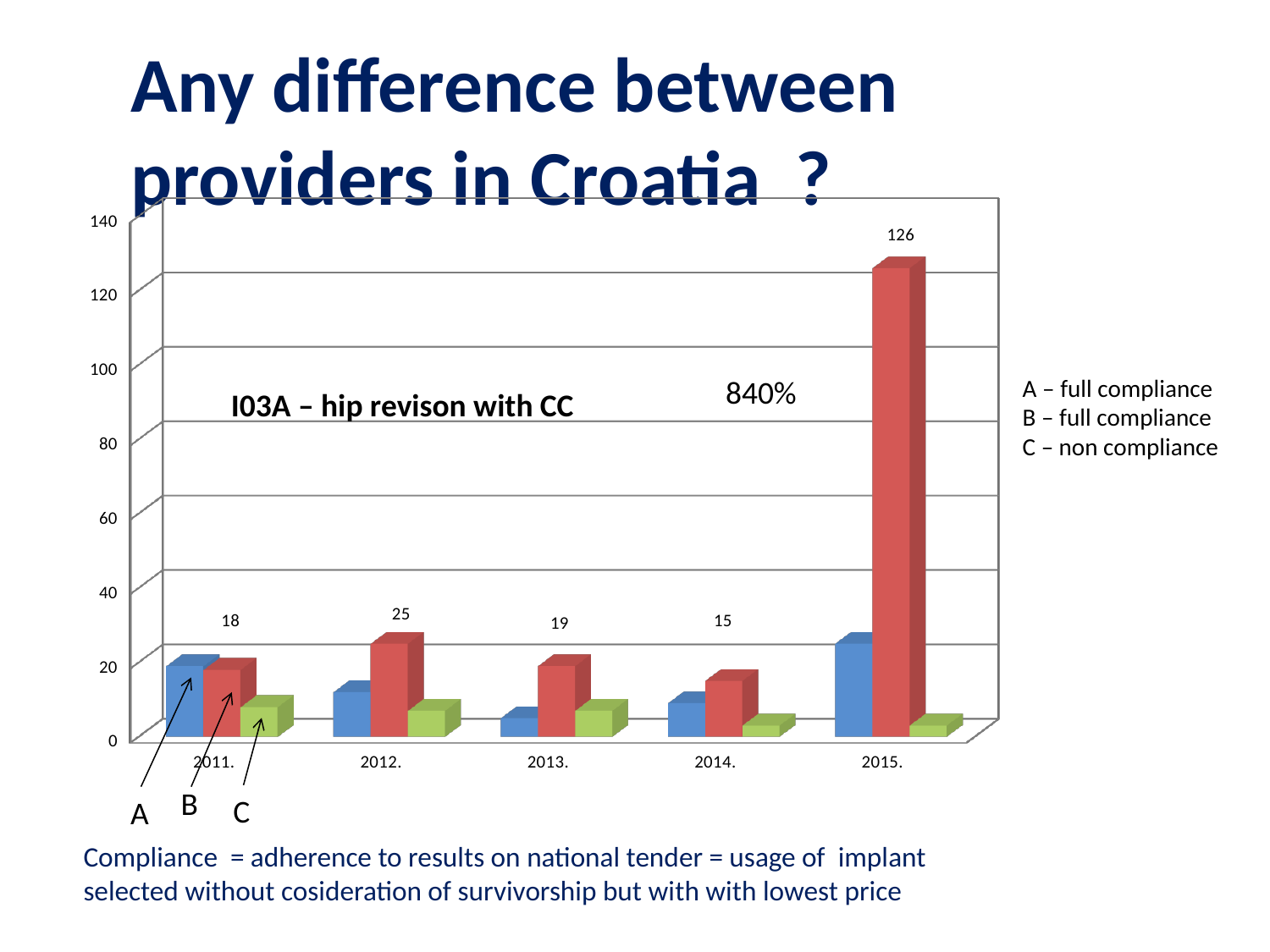
In which year is the labelled value for series B highest? 2015. What is the title printed inside the chart area? I03A – hip revison with CC What is the value labelled for series B in 2015? 126 How many years are shown on the x axis? 5 What is the value labelled for series B in 2014? 15 Which year has the larger series B value, 2012 or 2013? 2012. What is the difference between the series B values for 2015 and 2014? 111 What is the value labelled for series B in 2011? 18 In which year is the labelled value for series B lowest? 2014. What kind of chart is shown on the slide? bar chart Is the value for series A in 2015 greater or less than 40? less What is the value labelled for series B in 2012? 25